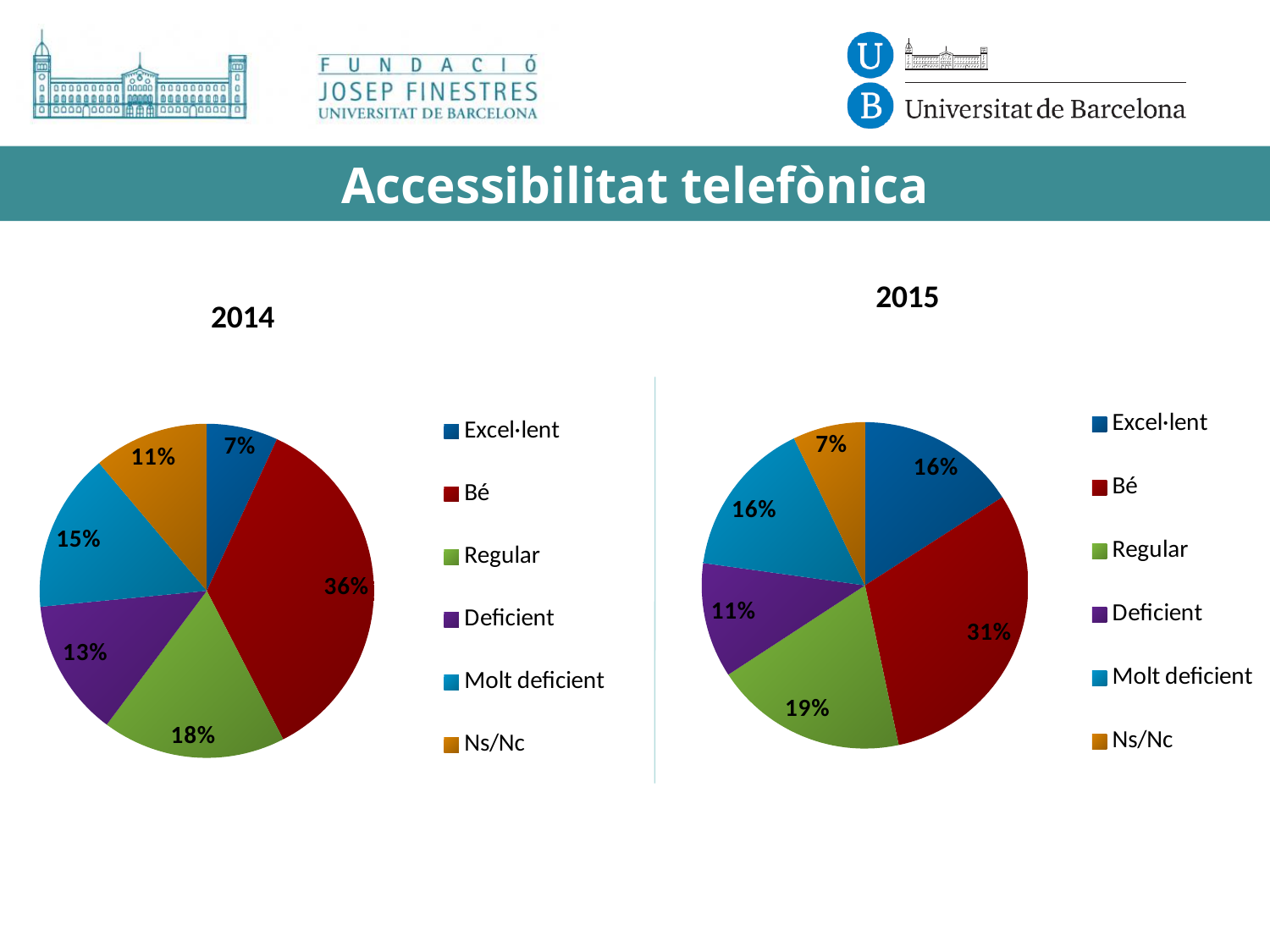
In the 2014 chart, which category has the largest slice? Bé In the 2015 chart, what percentage is labelled for Ns/Nc? 7% In the 2014 chart, which category has the smallest slice? Excel·lent In the 2014 chart, what percentage is labelled for Bé? 36% In the 2014 chart, which is larger: Regular or Deficient? Regular In the 2015 chart, what is the difference between the Bé and Regular percentages? 12% How many categories does the legend of the 2015 chart list? 6 In the 2014 chart, what percentage is labelled for Molt deficient? 15% In the 2015 chart, what percentage is labelled for Excel·lent? 16% In the 2015 chart, which category has the smallest slice? Ns/Nc What is the title of the 2015 chart? 2015 What kind of chart is the 2014 chart? Pie chart